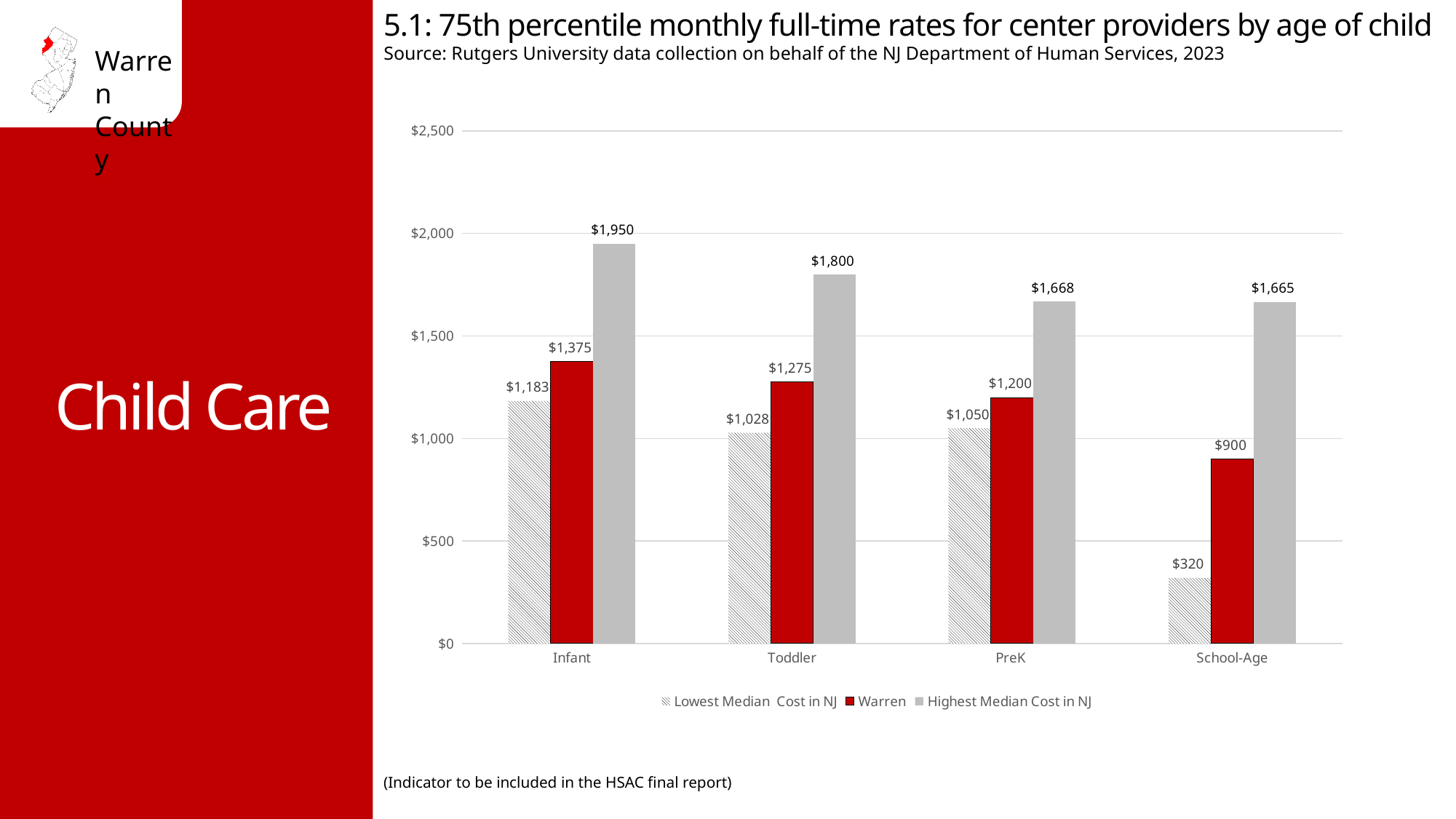
Which age category has the lowest Lowest Median Cost in NJ value? School-Age What kind of chart is shown on the slide? Bar chart Which is larger: the Warren value for Toddler or the Warren value for PreK? Toddler How many age categories are shown on the x axis? 4 What is the Lowest Median Cost in NJ for School-Age? $320 Which age category has the highest Warren value? Infant How many series does the legend list? 3 Which series is shown in red? Warren What is the difference between the Highest Median Cost in NJ and the Warren value for PreK? $468 What is the Warren value for Infant? $1,375 What is the Highest Median Cost in NJ for Toddler? $1,800 Is the Warren value for School-Age greater or less than $1,000? less